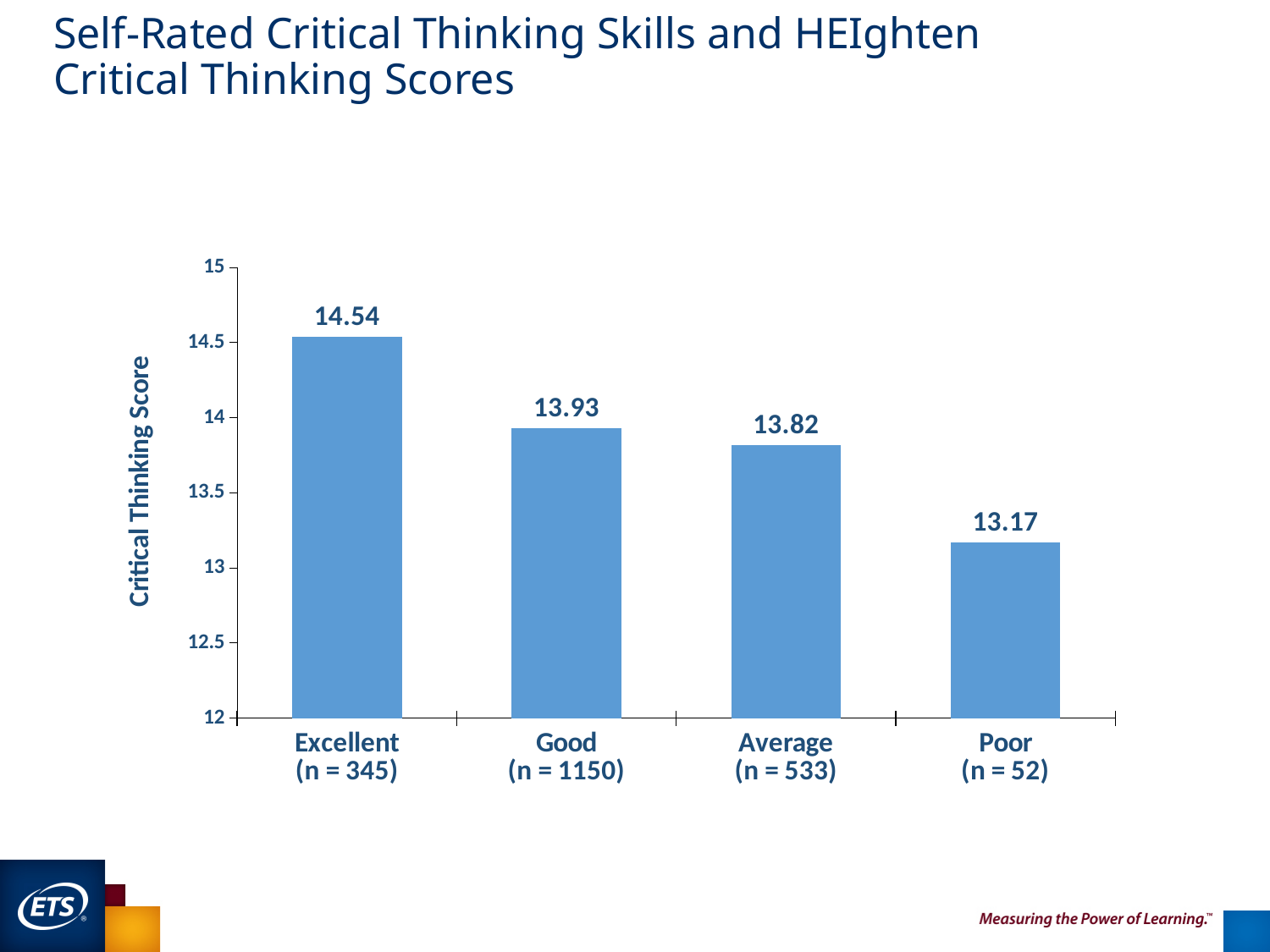
What is the Critical Thinking Score for the Excellent group? 14.54 Which group has a higher Critical Thinking Score, Good or Average? Good Do the Critical Thinking Scores rise or fall from Excellent to Poor along the x axis? fall What kind of chart is shown on the slide? bar chart What is the Critical Thinking Score for the Poor group? 13.17 What is the difference between the Critical Thinking Scores of the Excellent and Poor groups? 1.37 Is the Critical Thinking Score for the Average group greater or less than 14? less How many self-rated groups are shown on the chart? 4 What is the difference between the Critical Thinking Scores of the Good and Average groups? 0.11 Which self-rated group has the highest Critical Thinking Score? Excellent What is the Critical Thinking Score for the Good group? 13.93 Which self-rated group has the lowest Critical Thinking Score? Poor